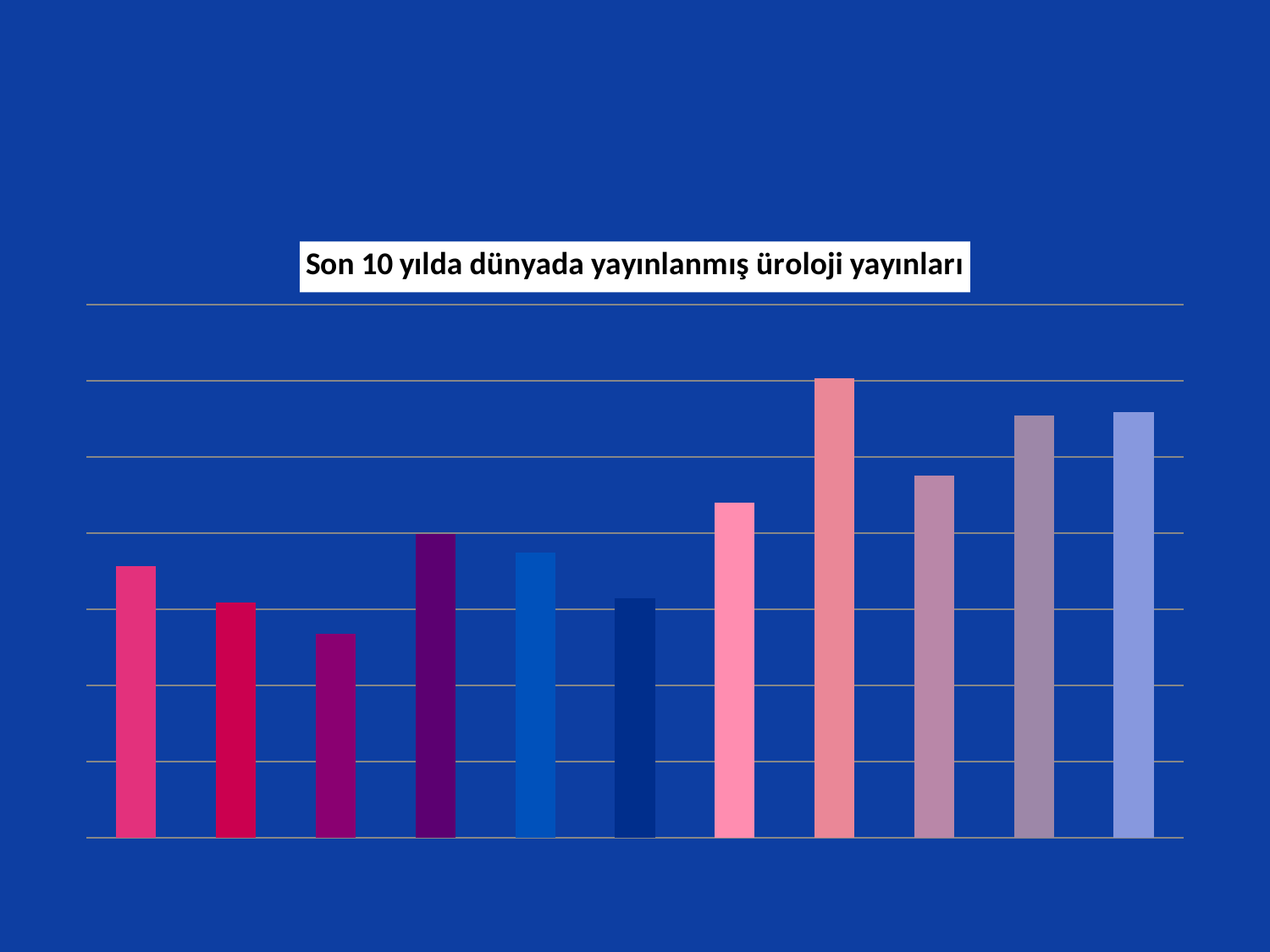
Counting from the left, which bar is the shortest in the chart? the 3rd bar Which is taller, the first bar from the left or the second bar from the left? the first bar Which is taller, the 9th bar from the left or the 10th bar from the left? the 10th bar What kind of chart is shown on the slide? bar chart What is the title of the chart? Son 10 yılda dünyada yayınlanmış üroloji yayınları Counting from the left, which bar is the tallest in the chart? the 8th bar Which is taller, the 7th bar from the left or the 6th bar from the left? the 7th bar How many bars does the chart contain? 11 Are the last five bars on the right generally taller or shorter than the first six bars on the left? taller Does the chart display a legend? No